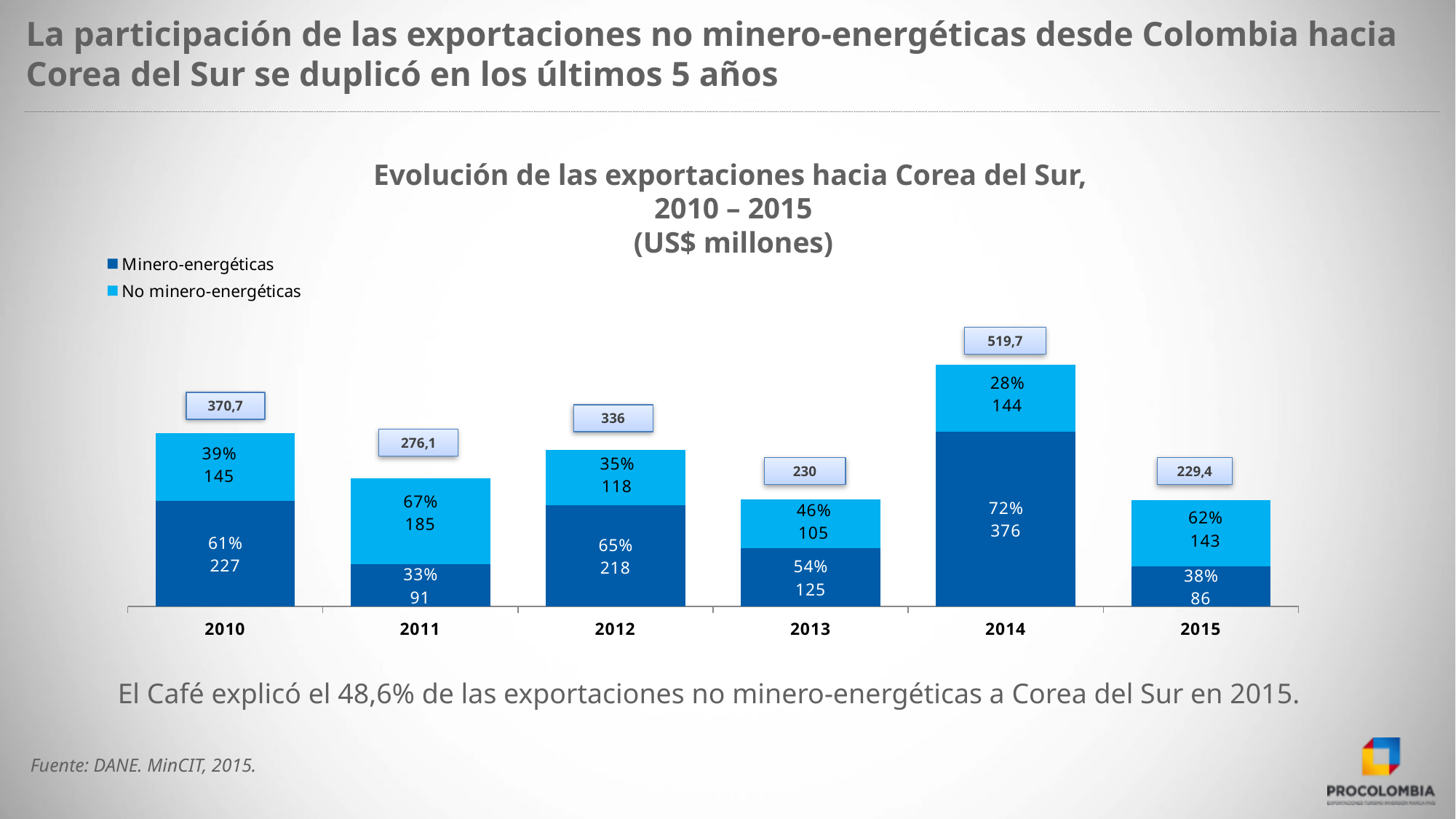
How many series does the legend list? 2 How many years are shown on the x axis? 6 What is the value of Minero-energéticas exports in 2014? 376 Which is larger in 2013: Minero-energéticas or No minero-energéticas exports? Minero-energéticas What is the title of the chart? Evolución de las exportaciones hacia Corea del Sur, 2010 – 2015 (US$ millones) Which year has the lowest value for Minero-energéticas exports? 2015 Which year has the highest total exports? 2014 What is the difference between Minero-energéticas and No minero-energéticas exports in 2010? 82 What is the total value of exports to Corea del Sur in 2014? 519,7 What type of chart is shown on the slide? Stacked bar chart What is the value of No minero-energéticas exports in 2011? 185 What percentage share did No minero-energéticas exports have in 2015? 62%